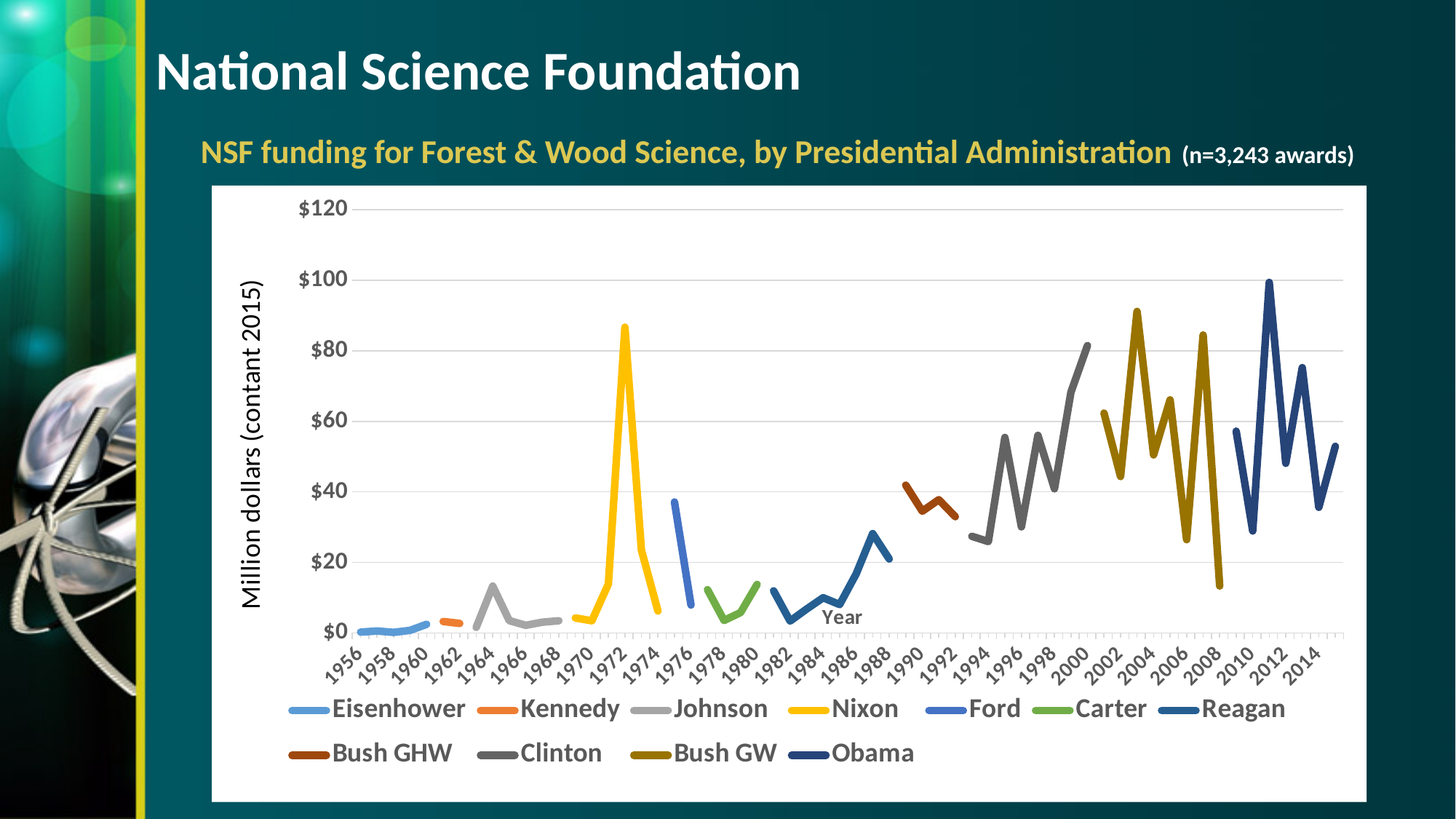
Is the peak value of the Nixon series greater or less than $80? greater Are the values of the Bush GHW series greater or less than $60? less What is the label of the vertical axis? Million dollars (contant 2015) What is the title of the chart? NSF funding for Forest & Wood Science, by Presidential Administration Which administration's series reaches the highest value on the chart? Obama Which series has higher values overall, Carter or Bush GW? Bush GW What kind of chart is shown on the slide? line chart Do the values of the Ford series rise or fall from 1975 to 1976? fall How many series does the legend list? 11 Are the values of the Eisenhower series greater or less than $20? less